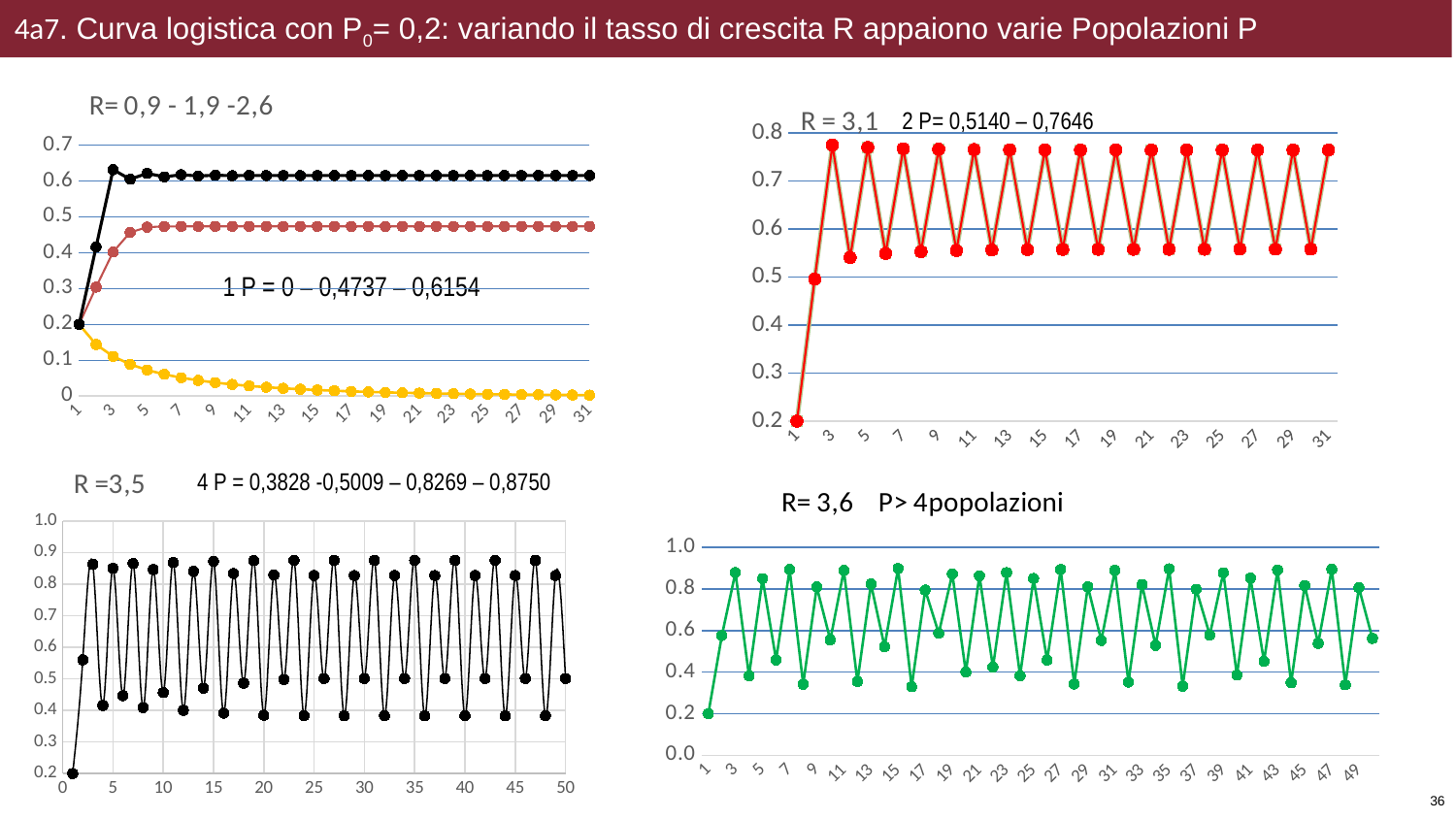
In the top-right chart titled "R = 3,1", are the trough values of the red line greater or less than 0.6? less In the bottom-right chart titled "R= 3,6", are the lowest points of the line greater or less than 0.4? less In the top-left chart titled "R= 0,9 - 1,9 -2,6", is the value of the yellow line at x = 31 greater or less than 0.1? less In the top-left chart titled "R= 0,9 - 1,9 -2,6", does the yellow line rise or fall along the x axis? fall In the top-left chart titled "R= 0,9 - 1,9 -2,6", how many lines are plotted? 3 What kind of chart is the top-left chart titled "R= 0,9 - 1,9 -2,6"? line chart In the top-left chart titled "R= 0,9 - 1,9 -2,6", which line has the highest value at x = 31: black, red or yellow? black In the bottom-left chart titled "R =3,5", what is the largest value shown on the x axis? 50 What colour is the line in the bottom-right chart titled "R= 3,6"? green